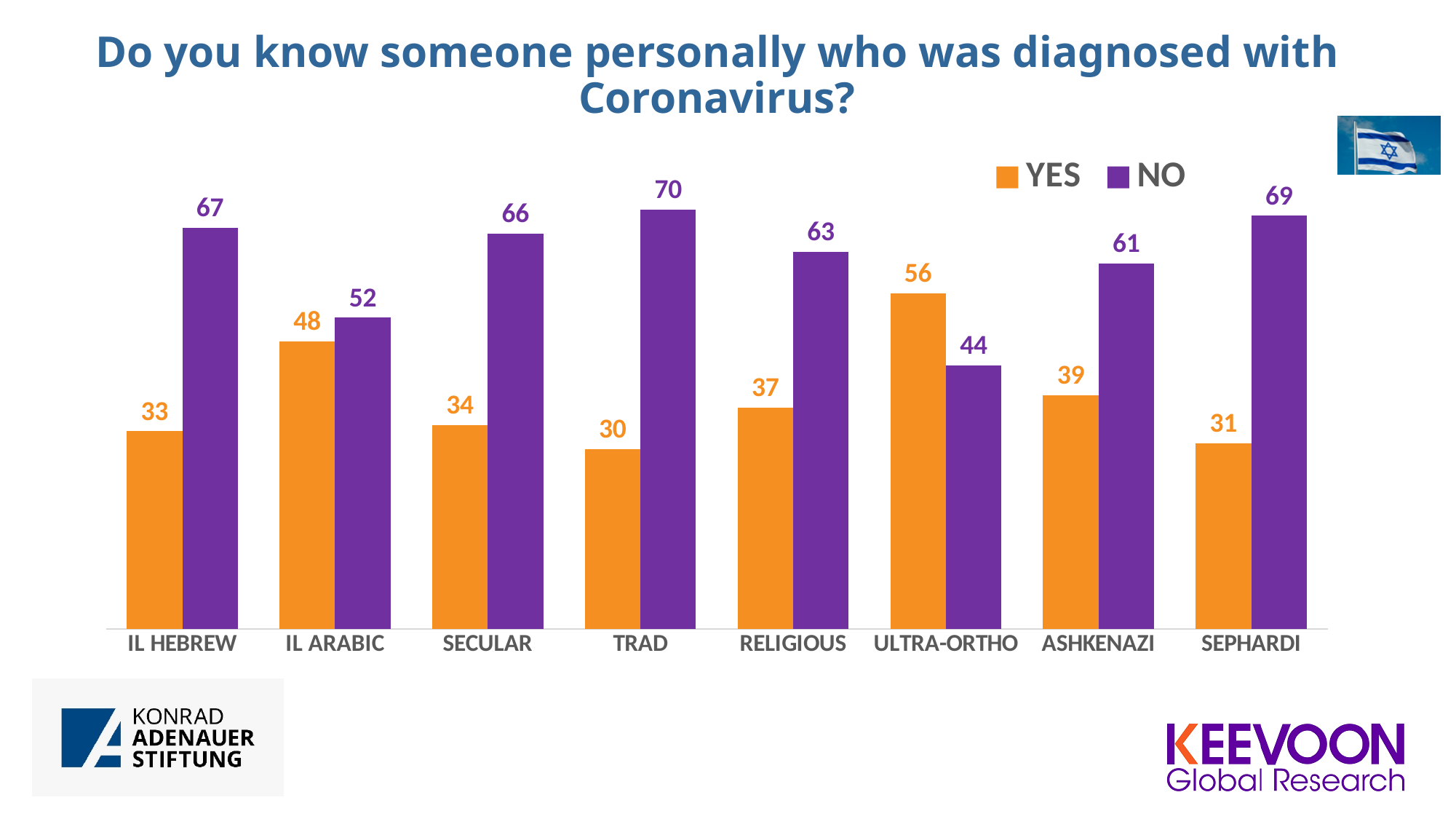
Which is larger for ULTRA-ORTHO, the YES value or the NO value? YES What is the YES value for ULTRA-ORTHO? 56 What is the YES value for IL ARABIC? 48 What is the difference between the NO and YES values for SEPHARDI? 38 Which category has the lowest YES value? TRAD What colour represents the NO series? Purple What is the difference between the YES values for ULTRA-ORTHO and IL HEBREW? 23 Which category has the highest NO value? TRAD What kind of chart is shown on the slide? Bar chart How many categories are shown on the x axis? 8 How many series does the legend list? 2 What is the NO value for TRAD? 70